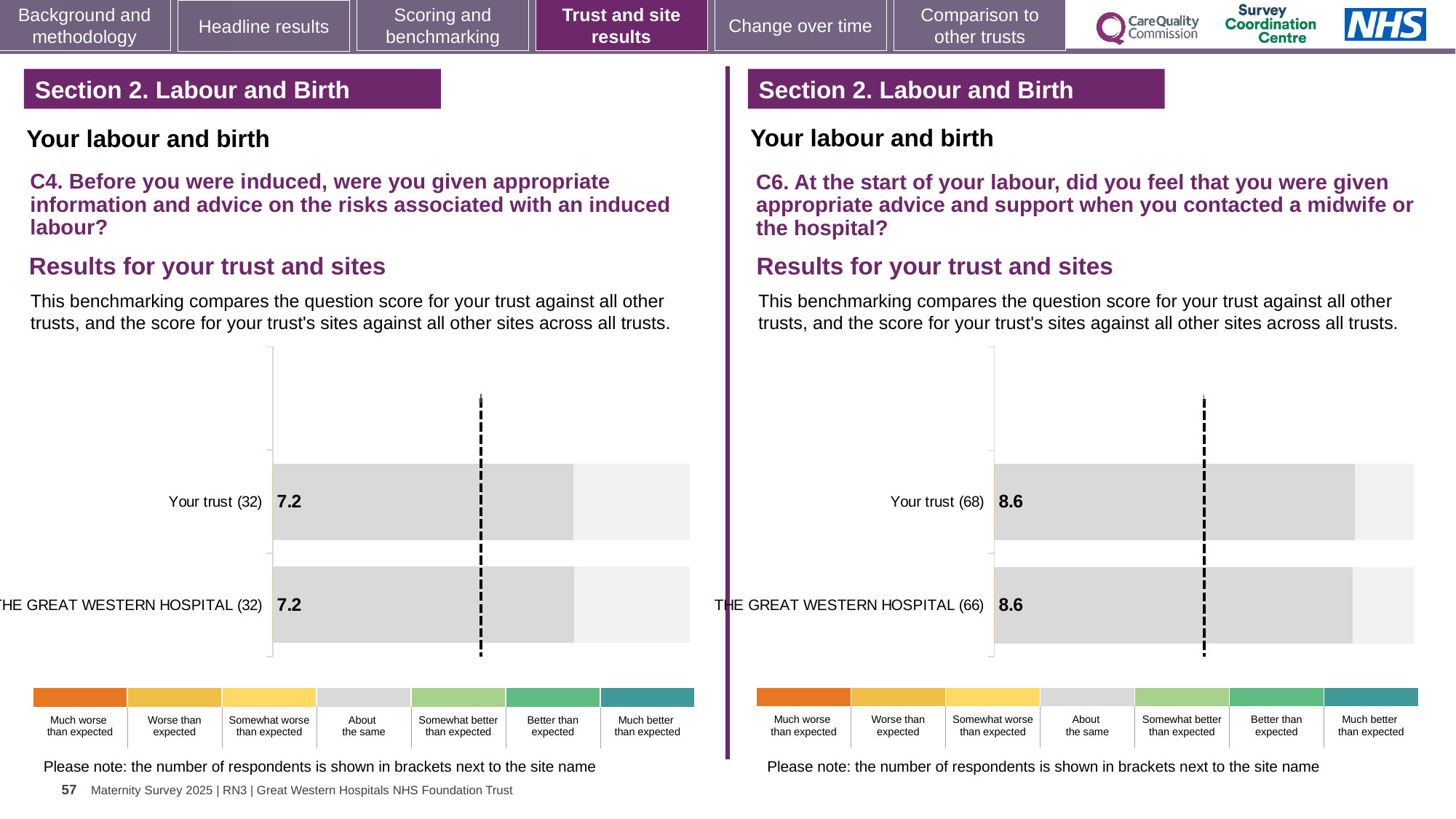
On the right chart (C6), what is the score for THE GREAT WESTERN HOSPITAL? 8.6 What kind of chart is used on the left (C4)? Bar chart On the left chart (C4), what is the difference between the Your trust score and THE GREAT WESTERN HOSPITAL score? 0 On the left chart (C4), what is the score for THE GREAT WESTERN HOSPITAL? 7.2 On the right chart (C6), what is the score for Your trust? 8.6 Is the Your trust score on the right chart (C6) larger or smaller than the Your trust score on the left chart (C4)? Larger How many bars are plotted on the left chart (C4)? 2 On the left chart (C4), what is the score for Your trust? 7.2 How many bars are plotted on the right chart (C6)? 2 On the right chart (C6), how many respondents are shown in brackets for THE GREAT WESTERN HOSPITAL? 66 On the right chart (C6), what is the difference between the Your trust score and THE GREAT WESTERN HOSPITAL score? 0 On the left chart (C4), how many respondents are shown in brackets for Your trust? 32